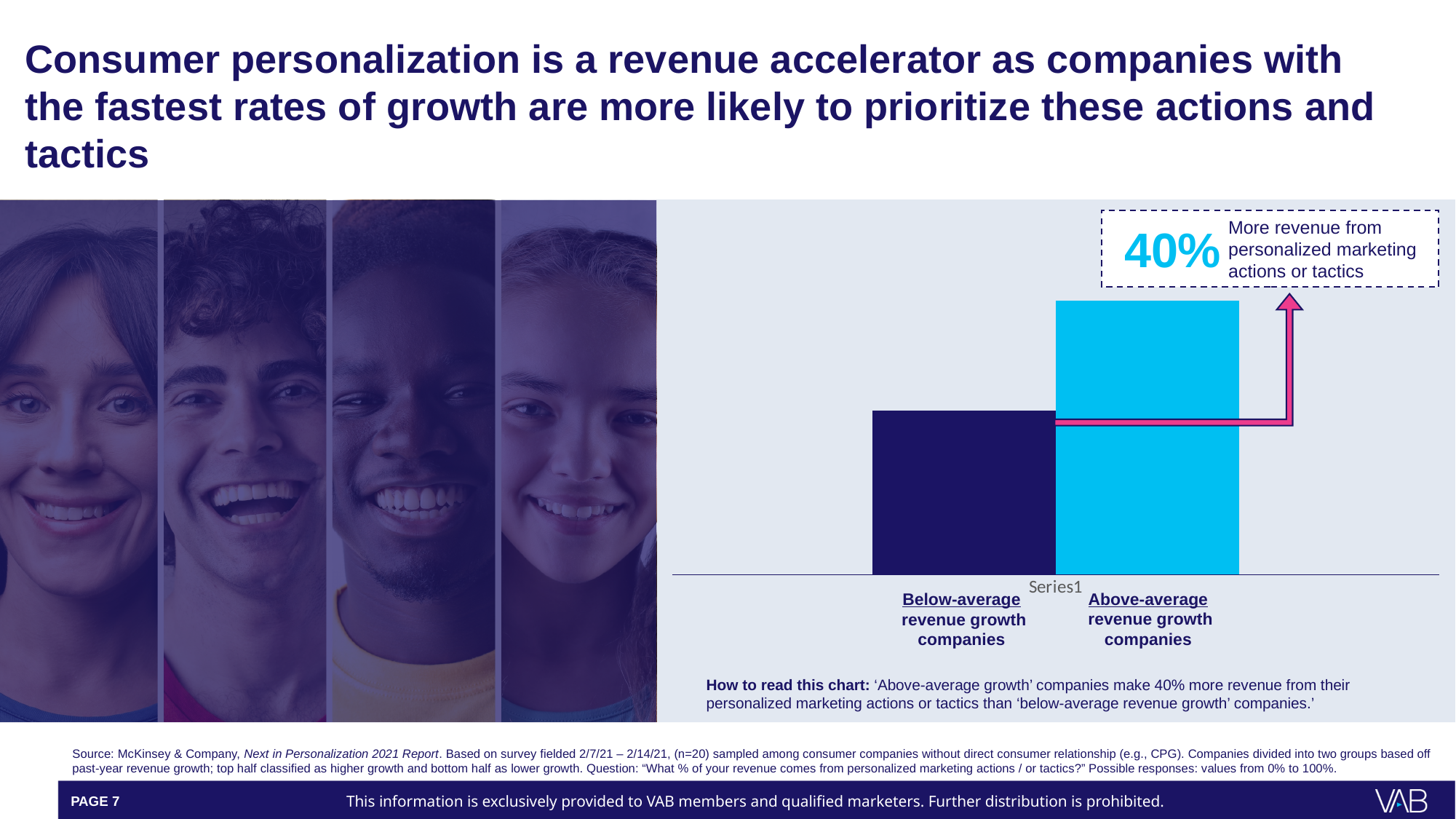
Which category has the shorter bar in the chart? Below-average revenue growth companies Is the bar for above-average revenue growth companies taller or shorter than the bar for below-average revenue growth companies? taller How many bars are plotted in the chart? 2 What colour is the bar for above-average revenue growth companies? light blue What colour is the bar for below-average revenue growth companies? dark navy According to the annotation on the chart, how much more revenue do above-average revenue growth companies get from personalized marketing actions or tactics? 40% What kind of chart is shown on the slide? bar chart Which category has the taller bar in the chart? Above-average revenue growth companies